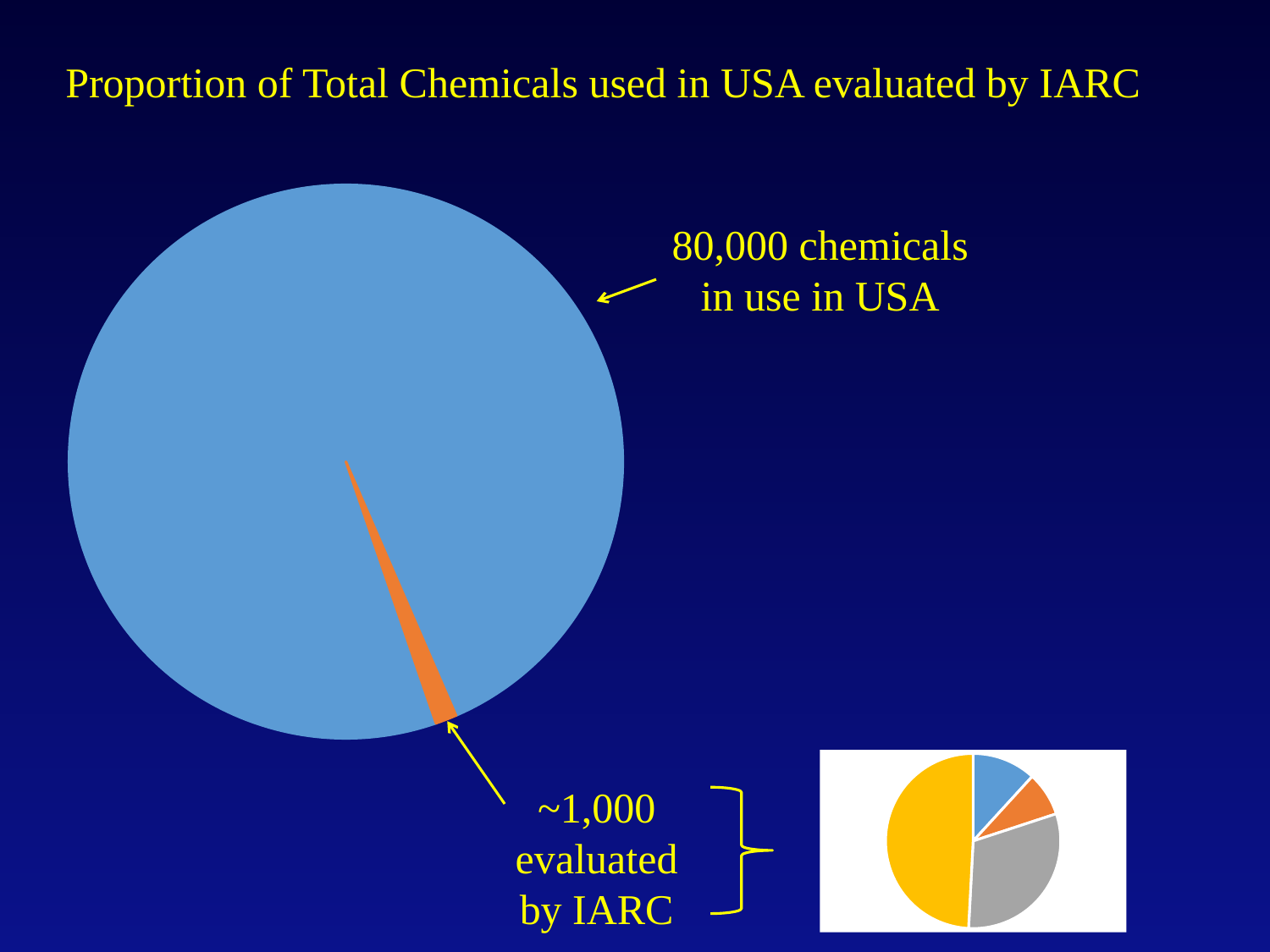
In the small pie chart in the bottom right corner, which slice is larger: the gray slice or the blue slice? gray How many slices does the small pie chart in the bottom right corner have? 4 In the large pie chart, how many chemicals are labelled as evaluated by IARC? ~1,000 In the large pie chart, which slice is the smallest? ~1,000 evaluated by IARC In the large pie chart, which slice is larger: chemicals in use in the USA or chemicals evaluated by IARC? chemicals in use in the USA In the small pie chart in the bottom right corner, which colour slice is the largest? yellow In the large pie chart, what colour is the slice representing chemicals evaluated by IARC? orange What is the title of the slide's chart? Proportion of Total Chemicals used in USA evaluated by IARC In the large pie chart, how many chemicals are labelled as in use in the USA? 80,000 In the small pie chart in the bottom right corner, which slice is larger: the yellow slice or the gray slice? yellow How many slices does the large pie chart have? 2 What type of chart is the large chart on the left of the slide? pie chart